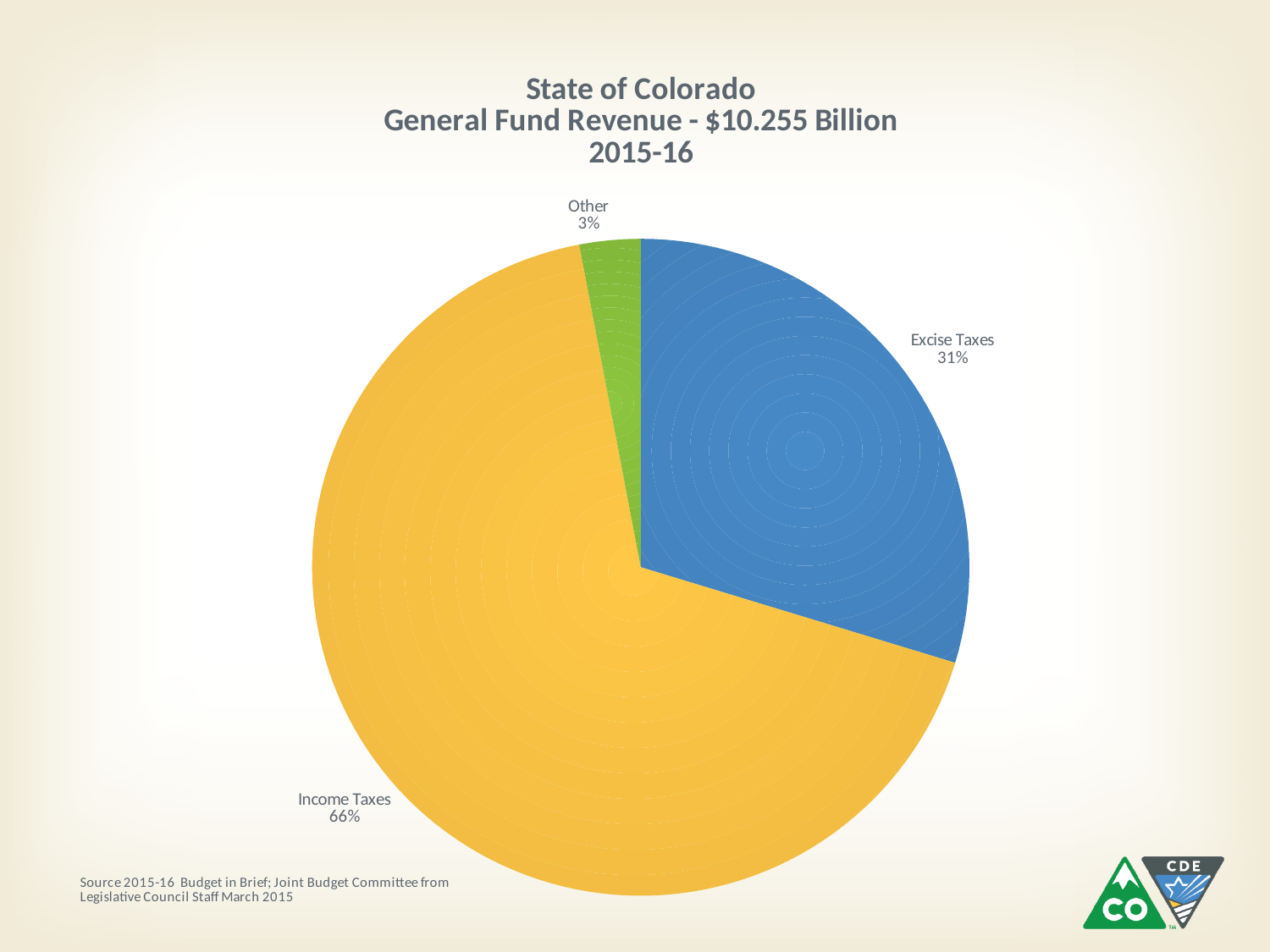
What total General Fund Revenue amount is stated in the chart title? $10.255 Billion What colour is the Income Taxes slice? yellow What kind of chart is shown on the slide? pie chart What share of General Fund Revenue comes from Other? 3% What is the difference in percentage points between Income Taxes and Excise Taxes? 35 Which category has the largest share of the pie? Income Taxes What share of General Fund Revenue comes from Excise Taxes? 31% What share of General Fund Revenue comes from Income Taxes? 66% Which category has the smallest share of the pie? Other What is the difference in percentage points between Excise Taxes and Other? 28 How many slices does the pie chart have? 3 Which is larger, the share for Excise Taxes or the share for Other? Excise Taxes